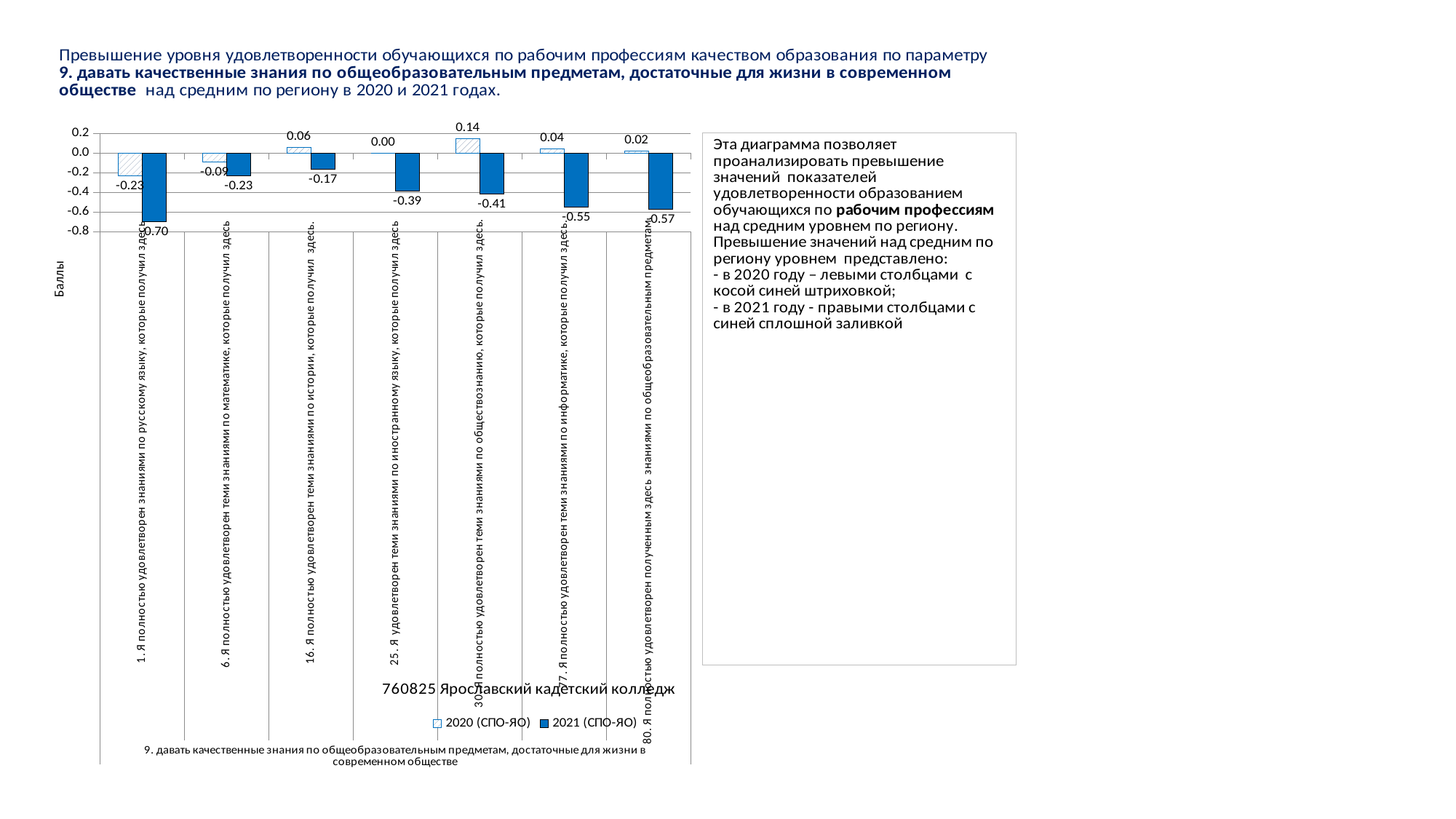
What is the label of the vertical axis of the chart? Баллы How many series does the chart legend list? 2 Which is larger for the mathematics category (item 6): the 2020 (СПО-ЯО) value or the 2021 (СПО-ЯО) value? 2020 (СПО-ЯО) What type of chart is shown on the slide? Bar chart What is the 2020 (СПО-ЯО) value for the category about knowledge of foreign language (item 25)? 0.00 Which category has the lowest 2021 (СПО-ЯО) value? 1. Я полностью удовлетворен знаниями по русскому языку, которые получил здесь What is the 2021 (СПО-ЯО) value for the category about knowledge of Russian language (item 1)? -0.70 Which category has the highest 2020 (СПО-ЯО) value? 30. Я полностью удовлетворен теми знаниями по обществознанию, которые получил здесь How many categories are shown on the x axis of the chart? 7 What is the 2021 (СПО-ЯО) value for the category about knowledge of informatics (item 77)? -0.55 What is the difference between the 2020 and 2021 values for the category about knowledge of history (item 16)? 0.23 What is the 2020 (СПО-ЯО) value for the category about knowledge of social studies (обществознание, item 30)? 0.14